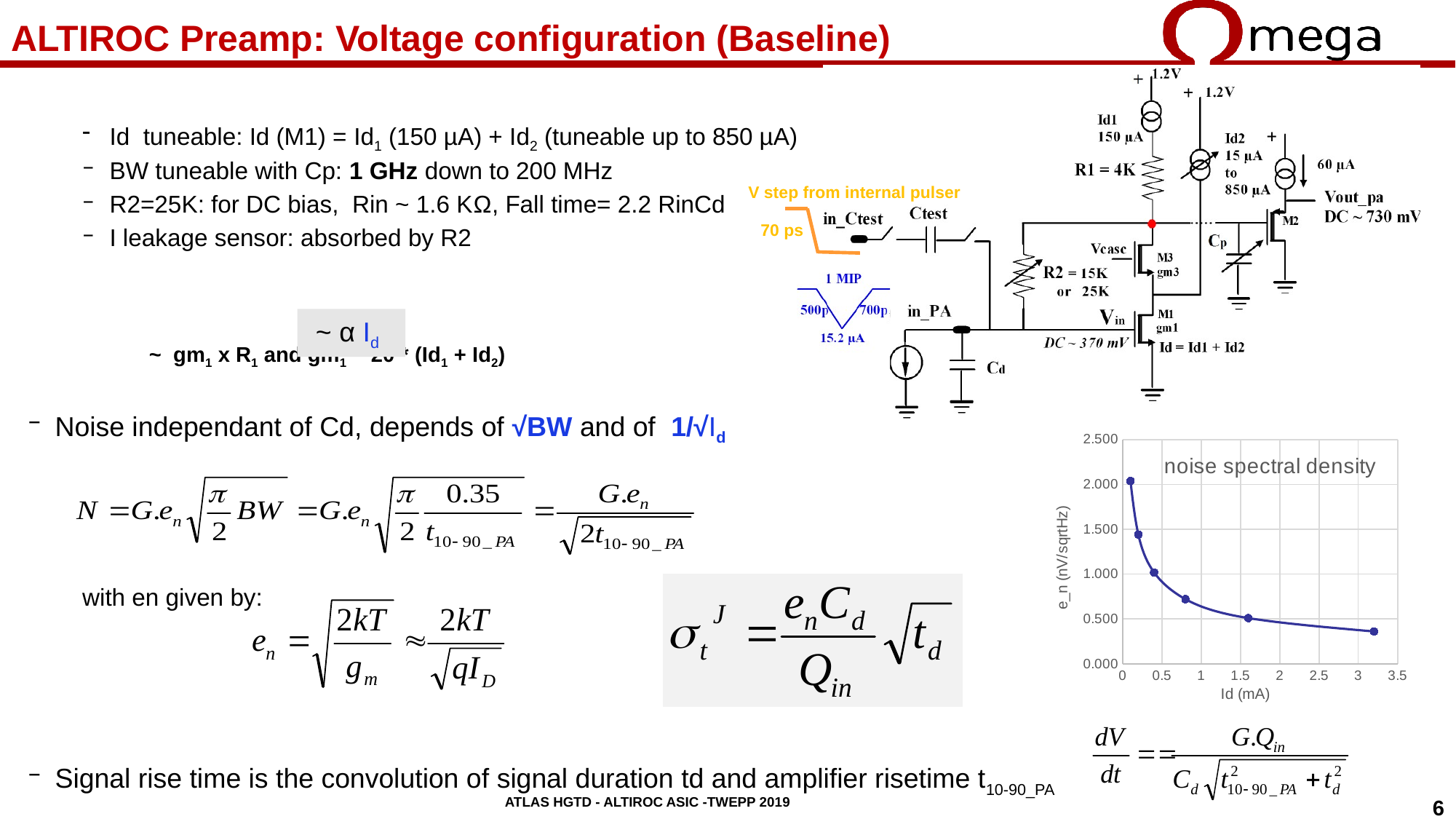
What is the label of the x axis of the noise spectral density chart? Id (mA) On the noise spectral density chart, is the e_n value at Id of about 0.8 mA greater or less than 0.500? greater How many data points are plotted on the noise spectral density chart? 6 On the noise spectral density chart, which plotted point has the highest e_n: the one at the smallest Id or the one at the largest Id? the one at the smallest Id On the noise spectral density chart, is the e_n value at the largest Id (about 3.2 mA) greater or less than 0.500? less What is the title of the chart on the slide? noise spectral density On the noise spectral density chart, is the e_n value at the smallest Id greater or less than 1.500? greater What is the maximum value shown on the y axis of the noise spectral density chart? 2.500 On the noise spectral density chart, is e_n larger at Id of about 0.2 mA or at Id of about 1.6 mA? Id of about 0.2 mA What kind of chart is the noise spectral density chart? line chart On the noise spectral density chart, does e_n rise or fall as Id increases? fall